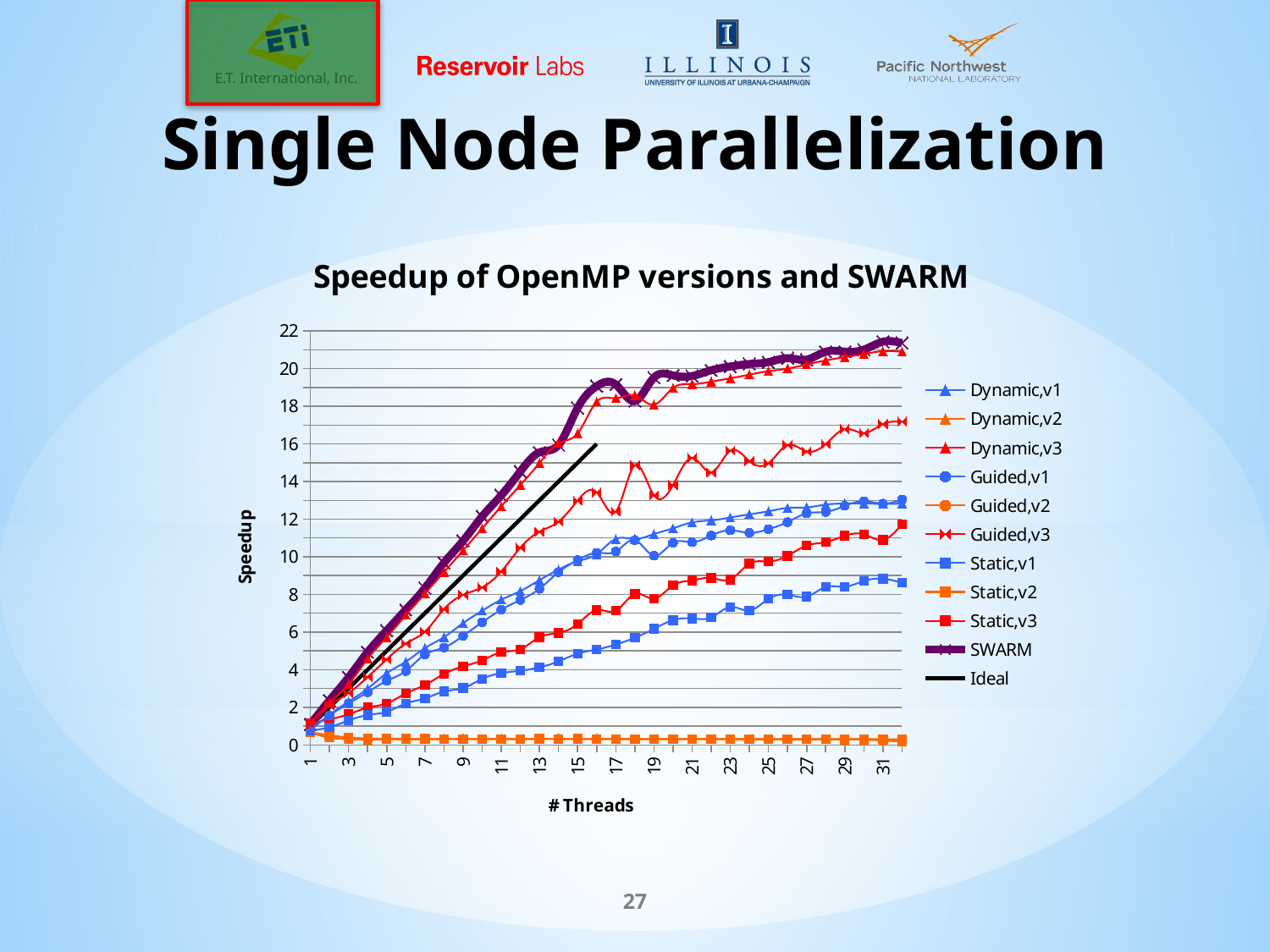
At 31 threads, which has the higher speedup, Guided,v3 or Static,v3? Guided,v3 Is the SWARM speedup at 31 threads greater or less than 20? greater Is the Static,v1 speedup at 31 threads greater or less than 10? less Is the Dynamic,v1 speedup at 31 threads greater or less than 12? greater How many series does the legend list? 11 At 31 threads, which has the higher speedup, Dynamic,v1 or Static,v1? Dynamic,v1 What is the label of the x axis? # Threads What is the title of the chart? Speedup of OpenMP versions and SWARM What kind of chart is shown on the slide? line chart Does the Static,v1 speedup rise or fall as the number of threads increases? rise